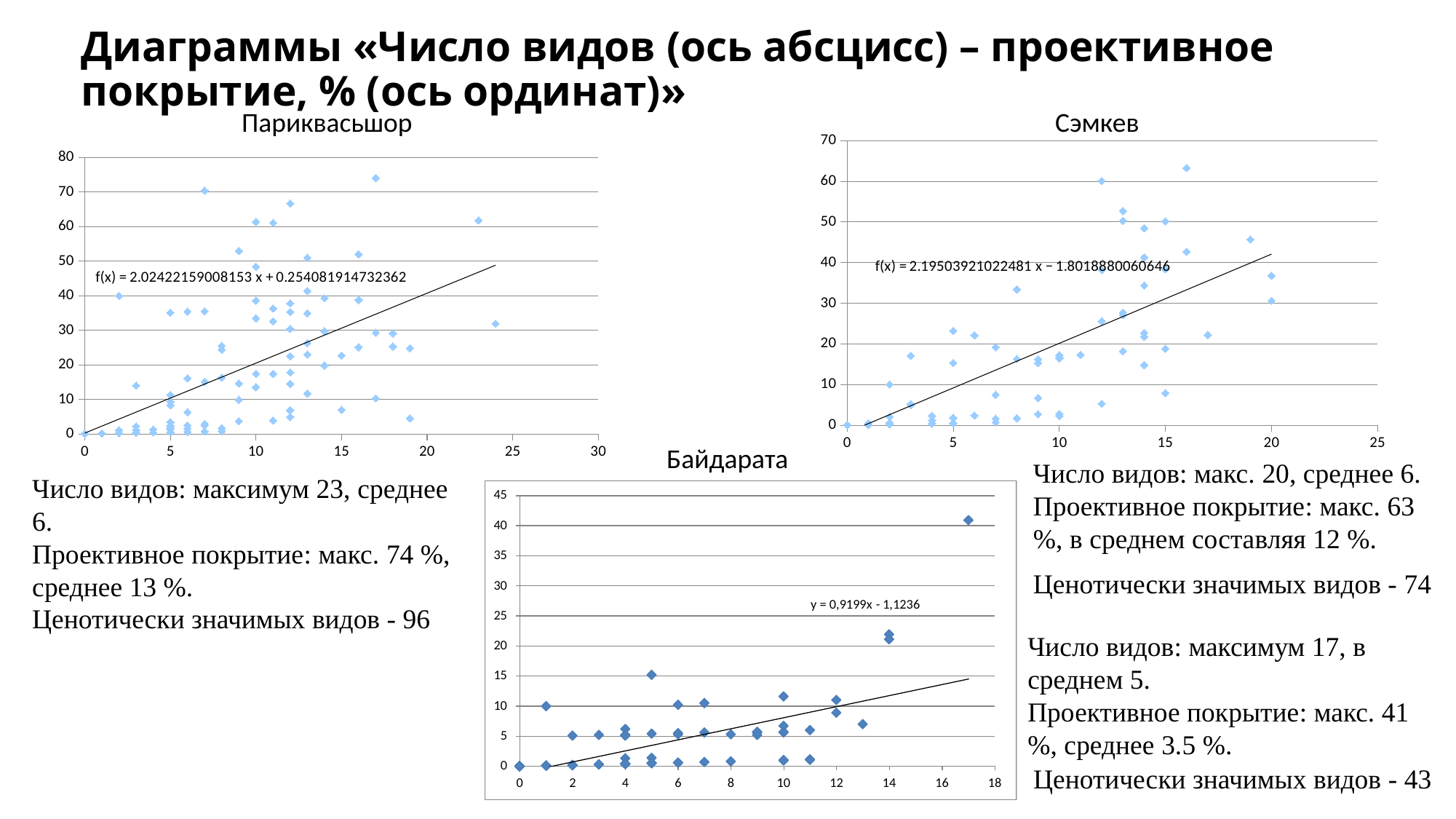
What is the trend line equation printed on the Сэмкев chart? f(x) = 2.19503921022481 x − 1.8018880060646 On the Париквасьшор chart, is the highest plotted point greater or less than 70? greater On the Байдарата chart, is the highest plotted point greater or less than 35? greater How many charts are shown on the slide? 3 What is the trend line equation printed on the Байдарата chart? y = 0,9199x - 1,1236 On the Байдарата chart, do the values generally rise or fall as the number of species increases along the x axis? rise What is the trend line equation printed on the Париквасьшор chart? f(x) = 2.02422159008153 x + 0.254081914732362 On the Сэмкев chart, is the highest plotted point greater or less than 50? greater On the Сэмкев chart, does the trend line rise or fall along the x axis? rise What is the maximum value shown on the vertical axis of the Байдарата chart? 45 What kind of chart is the Париквасьшор chart? scatter chart What is the title of the chart in the top right of the slide? Сэмкев